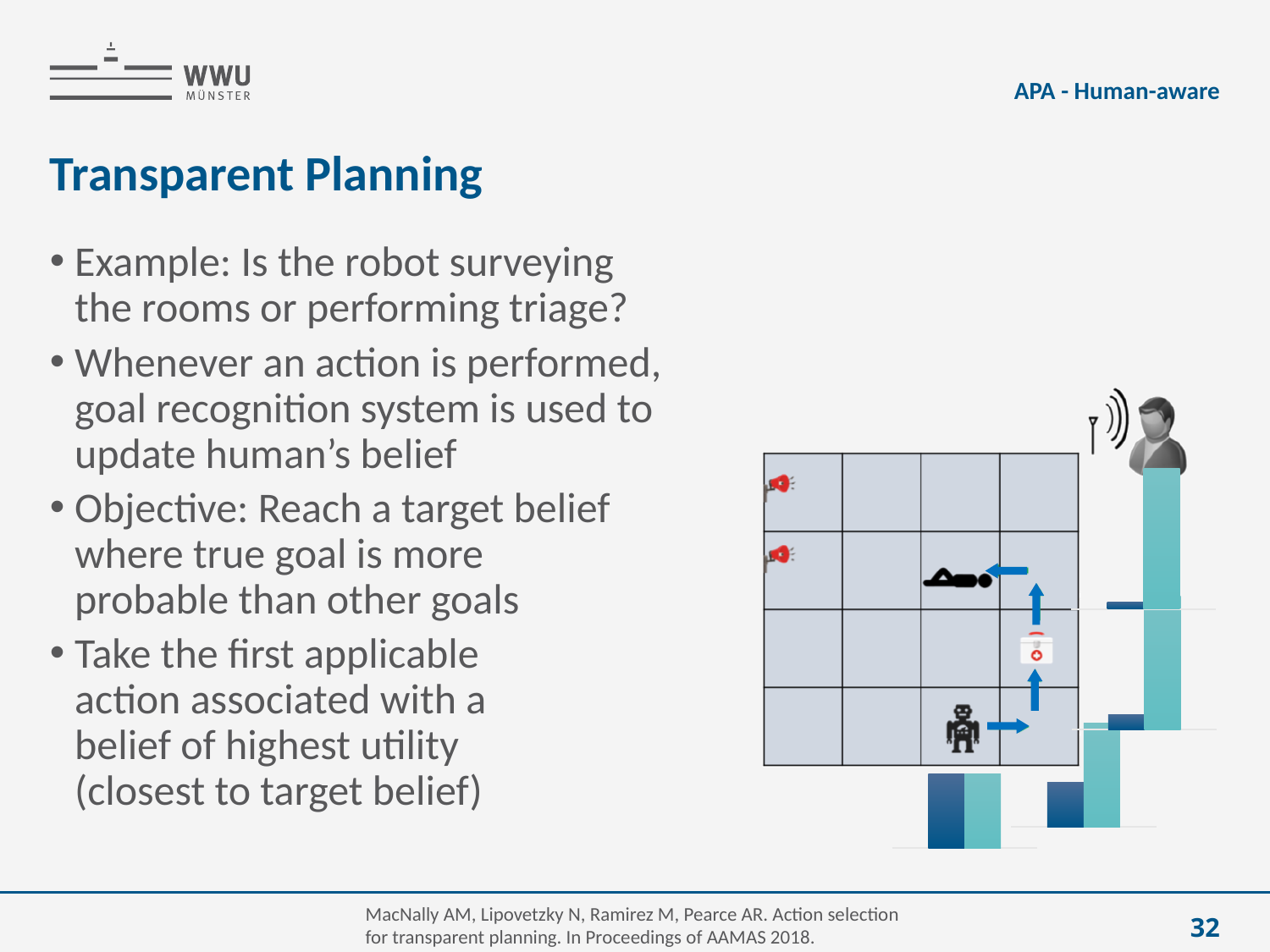
How many small bar charts are shown on the right side of the slide? 4 What two colours are used for the bars in the small bar charts? dark blue and teal What kind of charts are the small charts on the right side of the slide? bar chart How many bars does the bar chart at the far right (below the person icon) have? 2 Do the small bar charts on the slide show any axis labels or data labels? No How many bars does the bottom-left bar chart (below the grid) have? 2 In the bar chart at the far right (below the person icon), which bar is taller, the dark blue one or the teal one? teal In the middle bar chart (to the right of the grid's bottom row), which bar is taller, the dark blue one or the teal one? teal